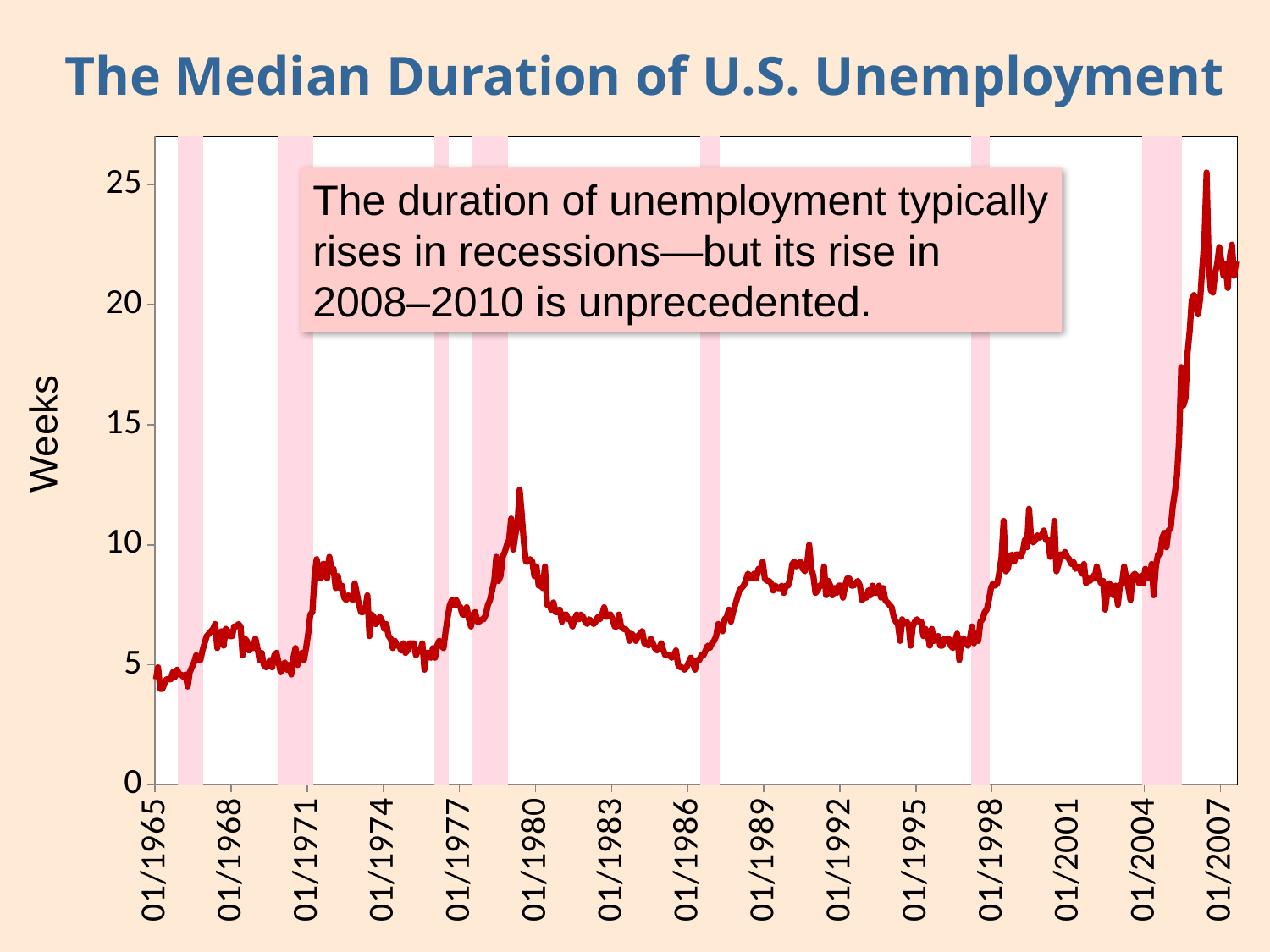
What kind of chart is shown on the slide? Line chart What is the title of the chart? The Median Duration of U.S. Unemployment How many series are plotted on the chart? 2 Is the value around 01/1992 greater or less than 10 weeks? less What unit is shown on the y-axis of the chart? Weeks How many year labels are shown along the x-axis? 15 Is the peak value of the line around 01/1980 greater or less than 10 weeks? greater Is the highest value reached at the right end of the chart greater or less than 20 weeks? greater In which part of the time range does the line reach its highest value? After 01/2007, at the far right Comparing the start of the series in 1965 with the end of the series after 2007, does the median duration rise or fall overall? Rise